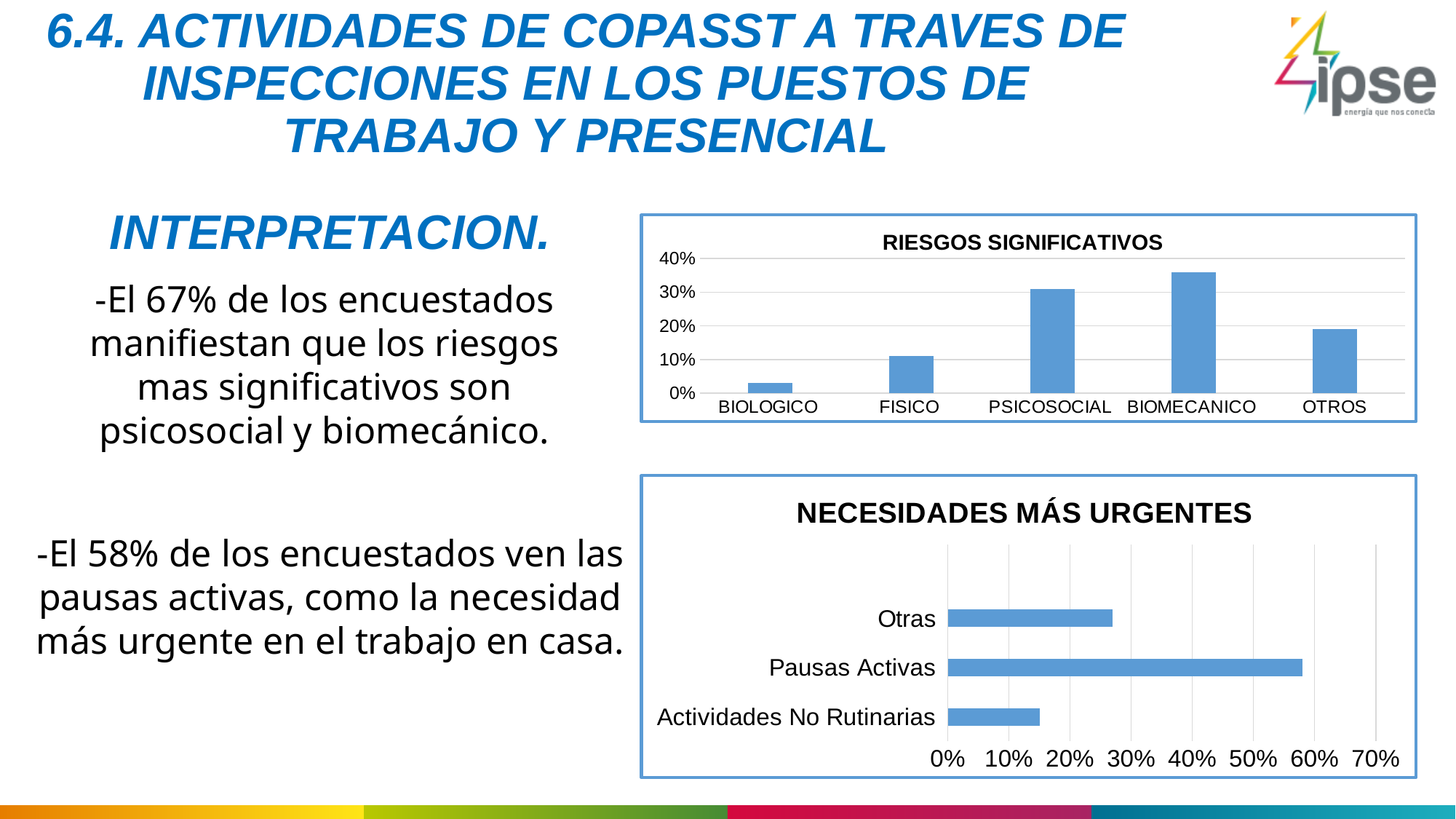
In the NECESIDADES MÁS URGENTES chart, which category has the highest value? Pausas Activas How many categories are shown in the NECESIDADES MÁS URGENTES chart? 3 In the RIESGOS SIGNIFICATIVOS chart, which category has the lowest value? BIOLOGICO How many categories are shown in the RIESGOS SIGNIFICATIVOS chart? 5 In the NECESIDADES MÁS URGENTES chart, is the value for Otras greater or less than 30%? less In the RIESGOS SIGNIFICATIVOS chart, which category has the highest value? BIOMECANICO In the NECESIDADES MÁS URGENTES chart, is the value for Pausas Activas greater or less than 50%? greater What kind of chart is the RIESGOS SIGNIFICATIVOS chart? Bar chart In the NECESIDADES MÁS URGENTES chart, which category has the lowest value? Actividades No Rutinarias In the RIESGOS SIGNIFICATIVOS chart, which is larger, FISICO or OTROS? OTROS